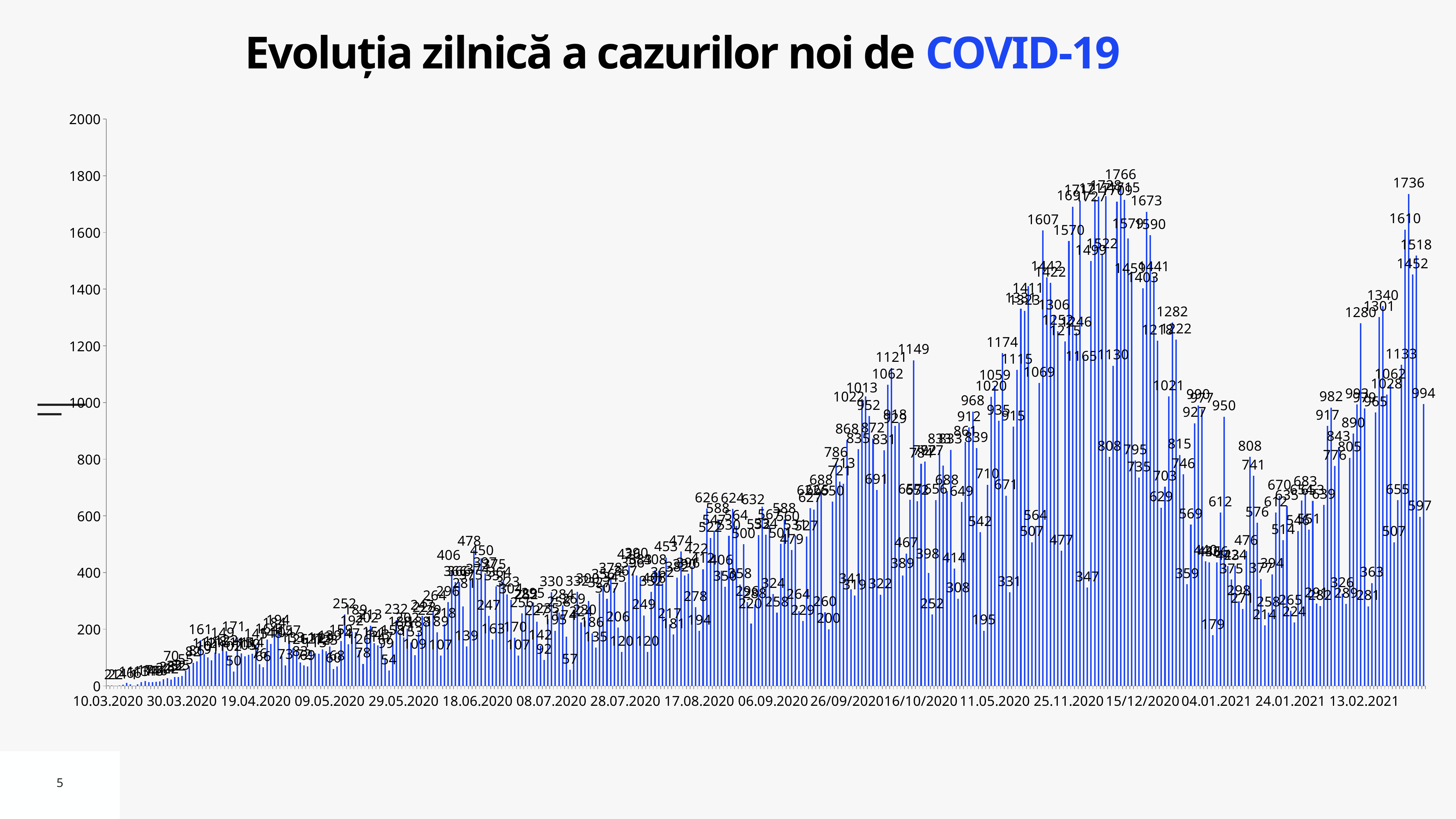
How many date labels are shown along the horizontal axis? 18 What is the difference between the two highest labeled values, 1766 and 1736? 30 What kind of chart is shown on the slide? bar chart What is the highest value labeled on the chart? 1766 What is the maximum value shown on the vertical axis? 2000 What is the highest value labeled in the final rise of the chart, near 13.02.2021? 1736 Which is larger, the peak value 1766 or the later peak value 1736? 1766 Overall, do the daily values rise or fall from 10.03.2020 to 13.02.2021? rise What is the title of the chart? Evoluția zilnică a cazurilor noi de COVID-19 Is the highest bar around 18.06.2020 greater or less than 500? less What is the first date label on the horizontal axis? 10.03.2020 Is the highest bar on the chart greater or less than 1800? less